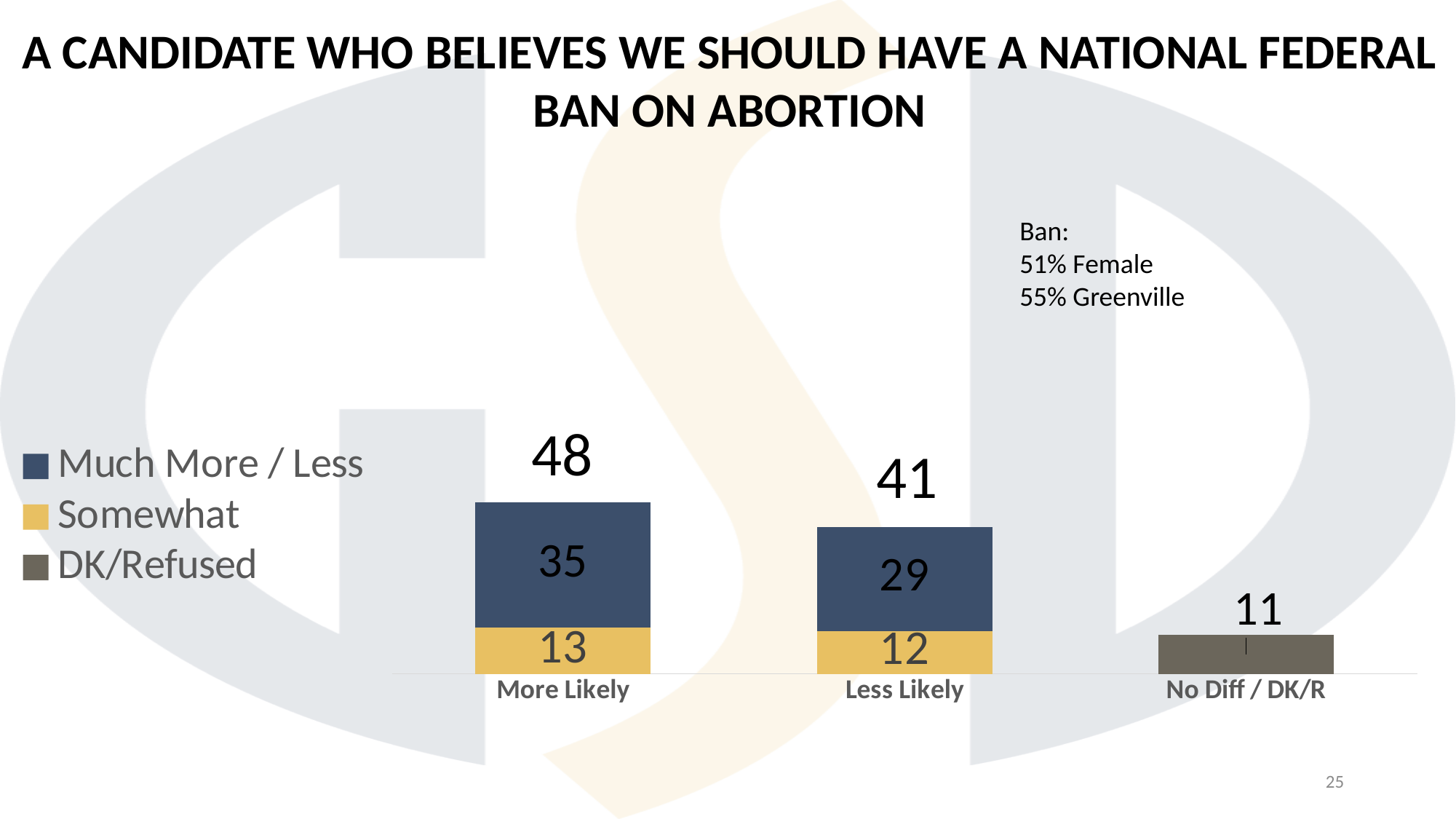
What is the total shown above the Less Likely bar? 41 What is the difference between the More Likely total and the Less Likely total? 7 What is the 'Much More / Less' value for the More Likely bar? 35 Which category has the lowest total? No Diff / DK/R How many categories are shown on the x axis? 3 Which category has the highest total? More Likely What is the value for No Diff / DK/R? 11 How many series does the legend list? 3 What is the total shown above the More Likely bar? 48 Which is larger, the 'Much More / Less' value for More Likely or for Less Likely? More Likely What is the 'Somewhat' value for the Less Likely bar? 12 What kind of chart is shown on the slide? Stacked bar chart